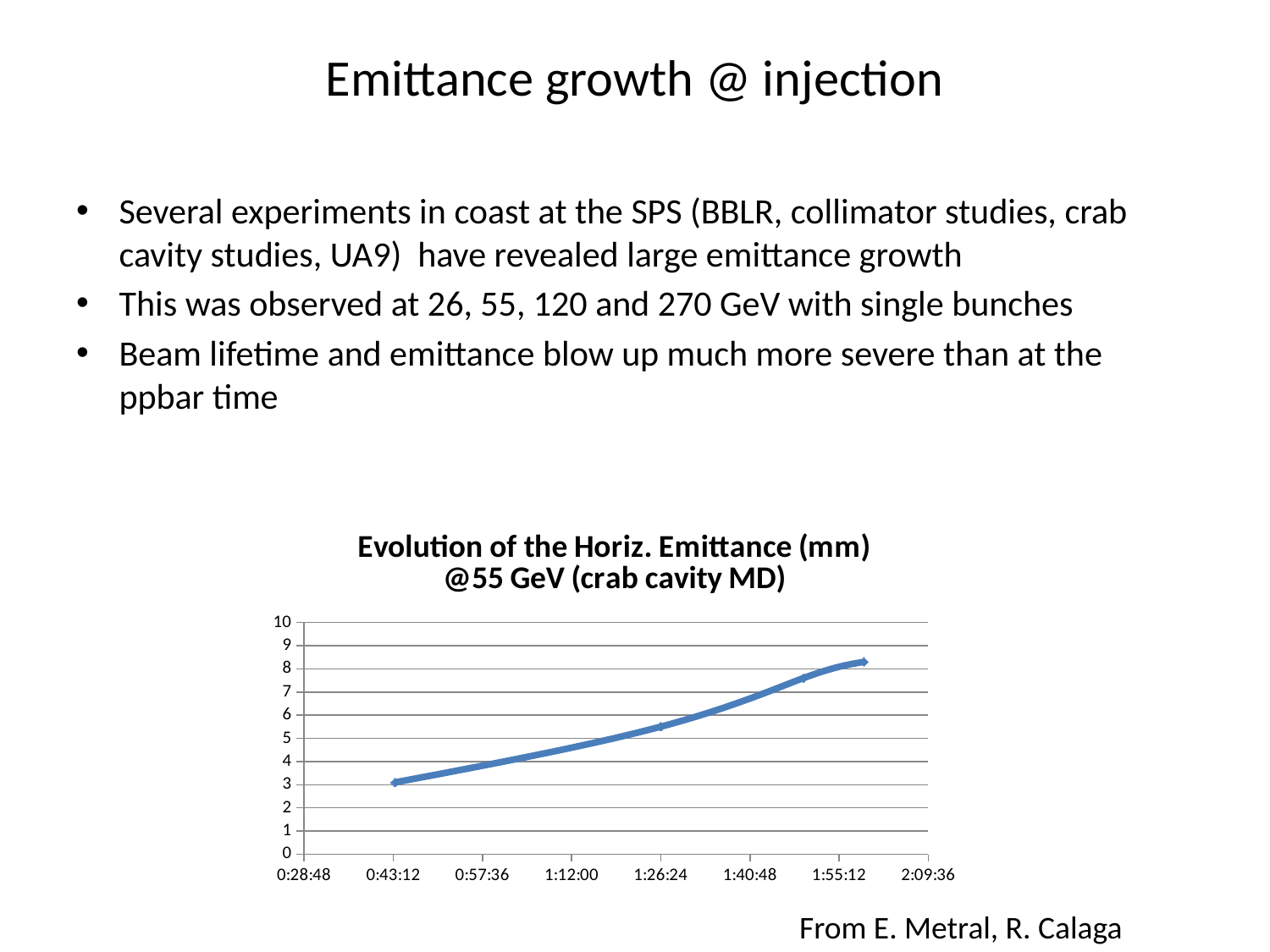
Which data point has the highest value, the first one or the last one? the last one How many data points are marked on the line? 4 Do the plotted values rise or fall as time increases along the x axis? rise Is the value of the data point at 1:26:24 greater or less than 4? greater What is the maximum value shown on the y axis? 10 Is the value of the first data point (near 0:43:12) greater or less than 2? greater What is the title of the chart? Evolution of the Horiz. Emittance (mm) @55 GeV (crab cavity MD) What kind of chart is shown on the slide? line chart Is the value of the first data point (near 0:43:12) greater or less than 4? less